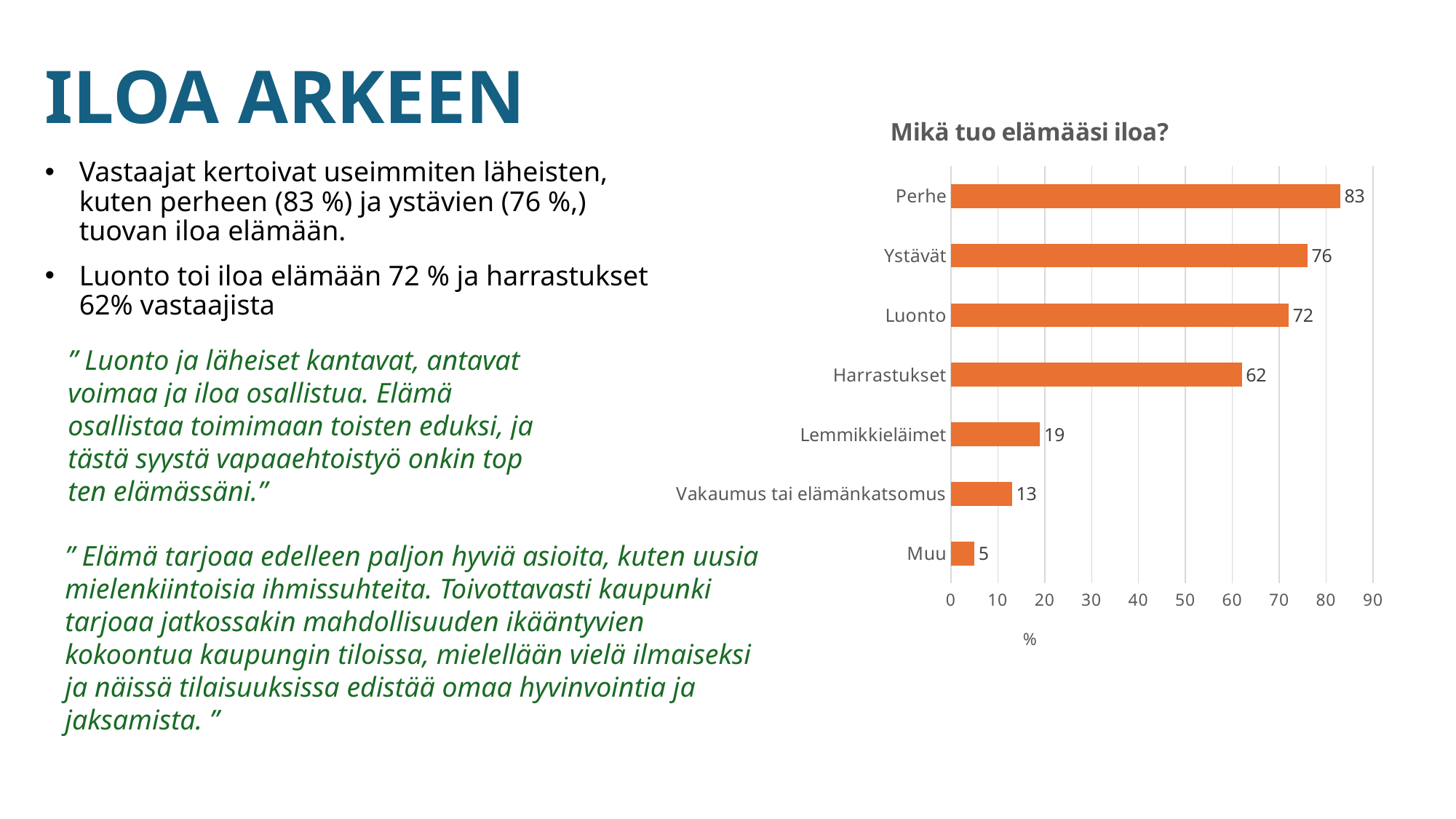
Which category has the highest value? Perhe What is the value for Perhe? 83 What is the title of the chart? Mikä tuo elämääsi iloa? Is the value for Ystävät greater or less than 70? greater What is the difference between the values for Luonto and Harrastukset? 10 What kind of chart is shown on the slide? bar chart How many categories are shown in the chart? 7 What is the value for Lemmikkieläimet? 19 What is the value for Vakaumus tai elämänkatsomus? 13 Which category has the lowest value? Muu What is the difference between the values for Perhe and Ystävät? 7 Which is larger, the value for Luonto or the value for Harrastukset? Luonto